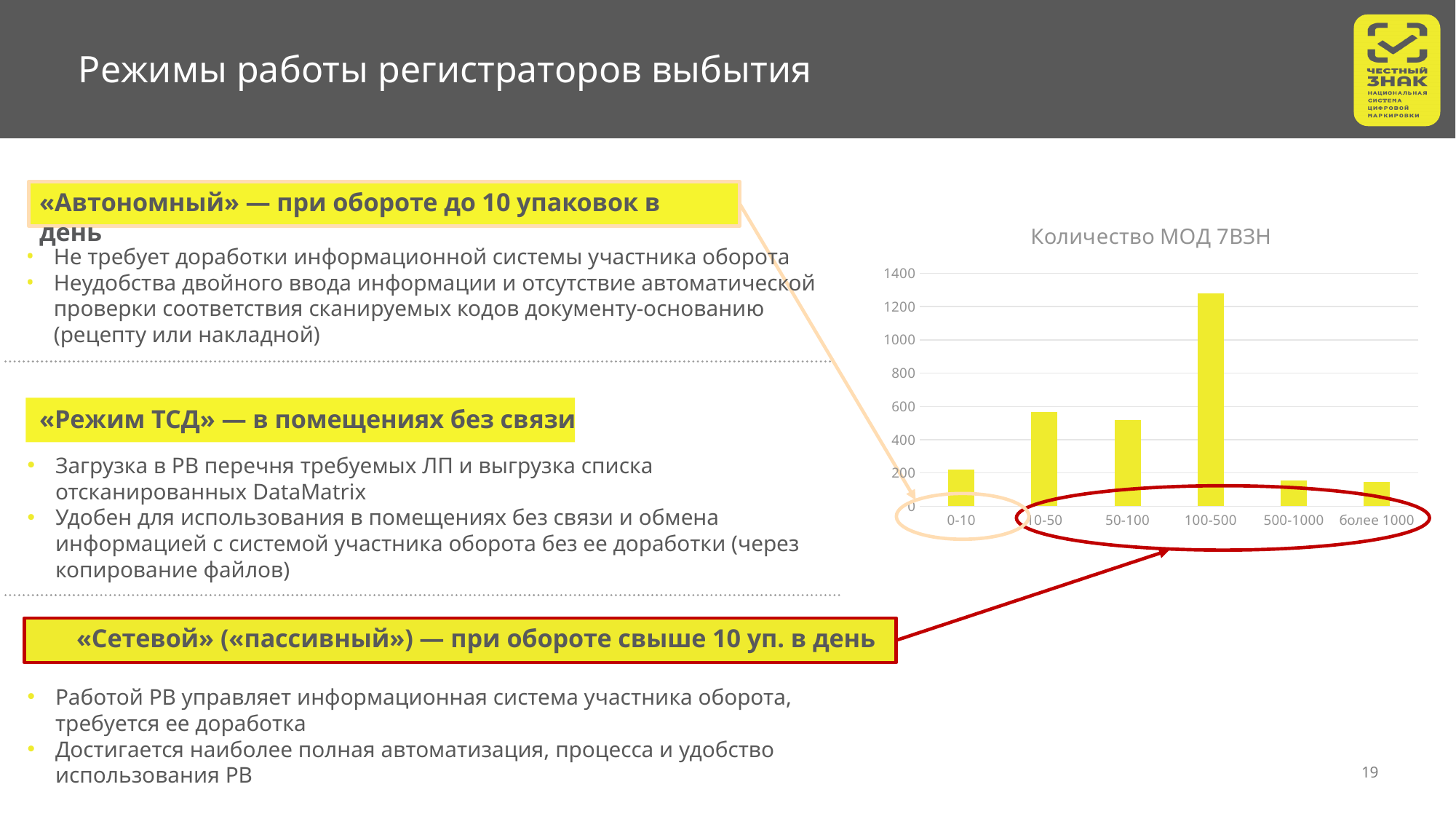
Is the value for 100-500 greater or less than 1200? greater Which is larger, the value for 100-500 or the value for 10-50? 100-500 What kind of chart is shown on the slide? bar chart Is the value for более 1000 greater or less than 200? less Which category has the highest value in the chart? 100-500 What is the title of the chart? Количество МОД 7ВЗН Which is larger, the value for 0-10 or the value for 50-100? 50-100 Is the value for 0-10 greater or less than 400? less How many categories are shown on the x axis of the chart? 6